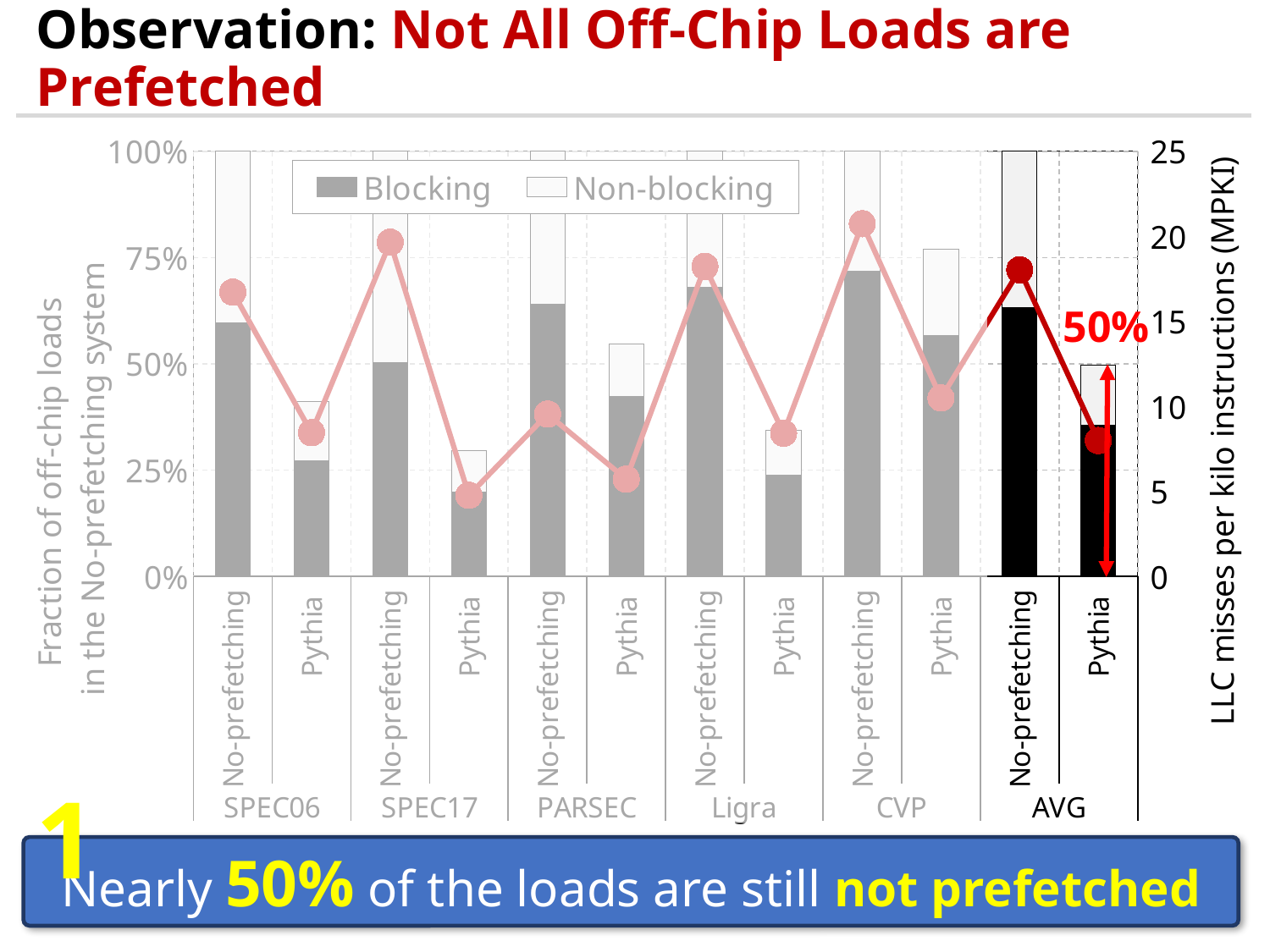
What is the label of the right-hand y axis? LLC misses per kilo instructions (MPKI) What is the total height of the No-prefetching bar in the AVG group? 100% Is the MPKI line value for No-prefetching in SPEC17 greater or less than 15? greater How many series does the legend list? 2 Is the Blocking portion of the No-prefetching bar for SPEC06 greater or less than 50%? greater What is the total height of the Pythia bar in the AVG group, as annotated on the chart? 50% What are the two series named in the legend? Blocking and Non-blocking What kind of chart is shown on the slide? Stacked bar chart with a line overlay Among the Pythia bars, which benchmark group has the tallest stacked bar? CVP How many bars are plotted in total? 12 How many benchmark groups are shown along the x axis? 6 Is the Blocking portion of the Pythia bar for SPEC17 greater or less than 25%? less